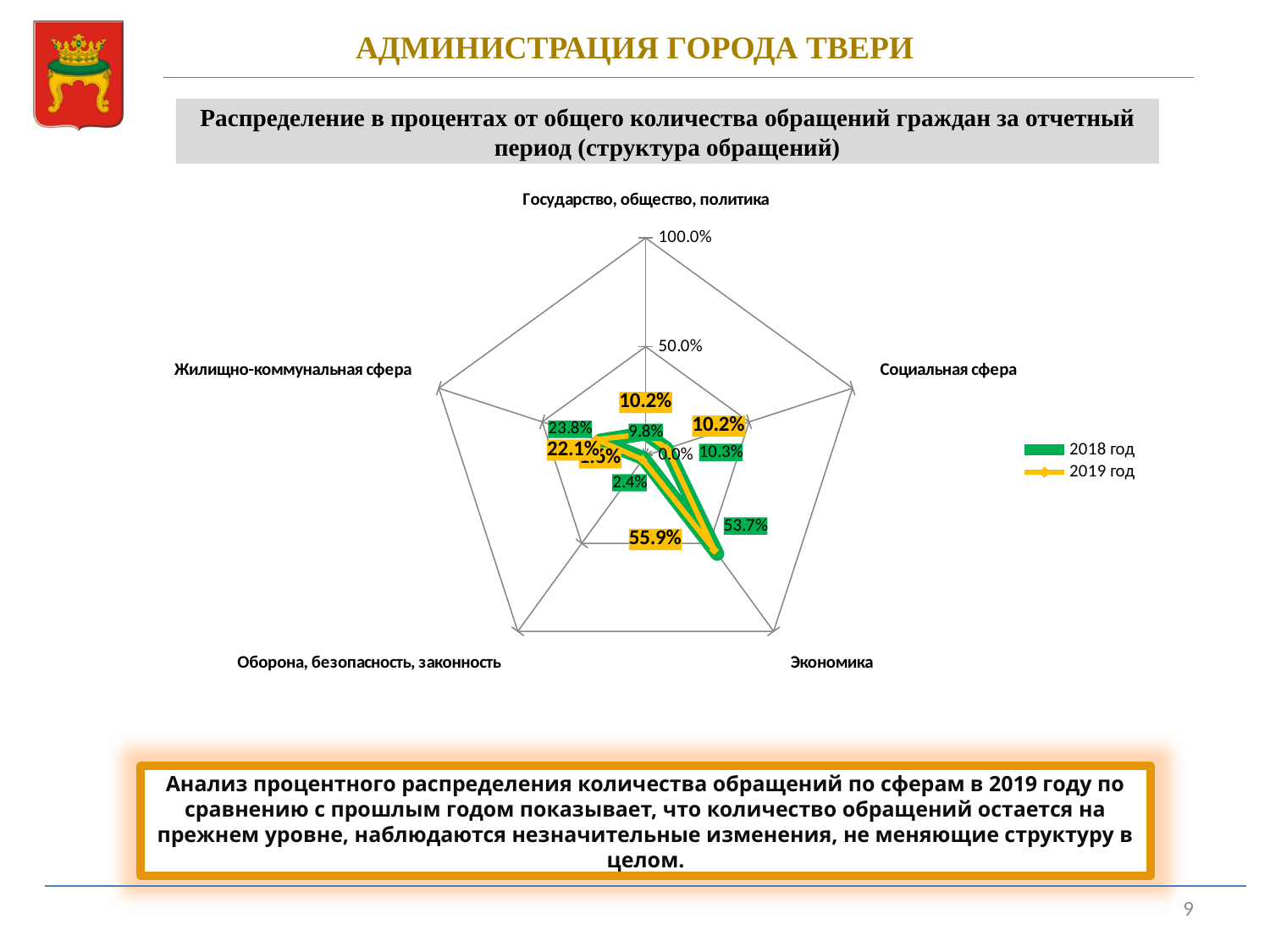
What kind of chart is shown on the slide? radar chart What is the value for Жилищно-коммунальная сфера in the 2018 год series? 23.8% How many categories (axes) does the radar chart have? 5 Which category has the highest value in the 2019 год series? Экономика Which category has the lowest value in the 2018 год series? Оборона, безопасность, законность What is the value for Социальная сфера in the 2018 год series? 10.3% What is the value for Жилищно-коммунальная сфера in the 2019 год series? 22.1% What is the difference between the 2019 год and 2018 год values for Экономика? 2.2% What is the value for Экономика in the 2019 год series? 55.9% Which series has the larger value for Жилищно-коммунальная сфера, 2018 год or 2019 год? 2018 год How many series does the legend list? 2 What is the value for Экономика in the 2018 год series? 53.7%